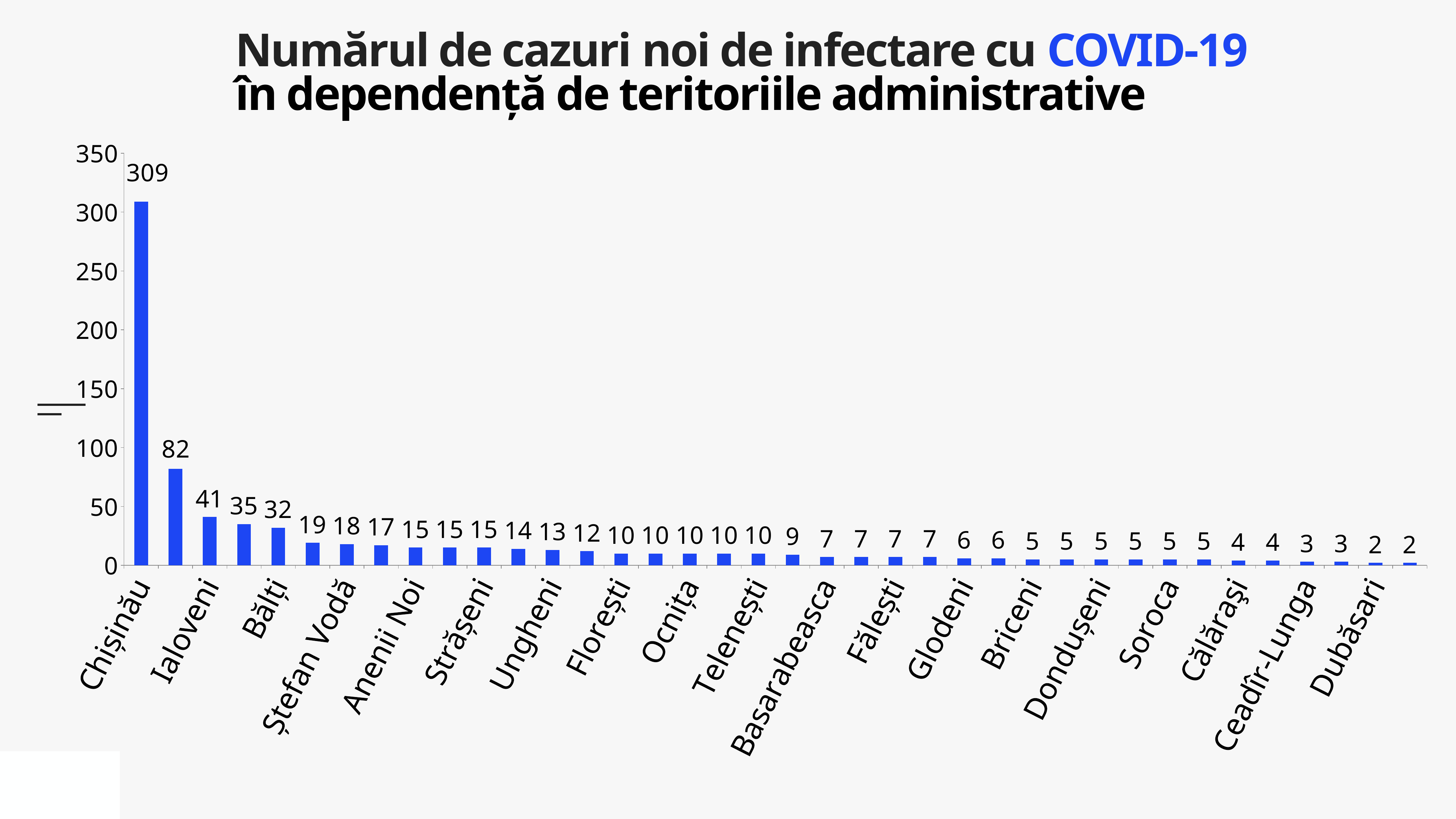
How many new COVID-19 cases are shown for Soroca? 5 Do the values rise or fall from left to right along the x axis? fall Which administrative territory has the highest number of new COVID-19 cases? Chișinău What type of chart is shown on the slide? bar chart How many new COVID-19 cases are shown for Dubăsari? 2 How many new COVID-19 cases are shown for Chișinău? 309 Is the value for Chișinău greater or less than 300? greater How many new COVID-19 cases are shown for Ocnița? 10 Which has more new cases, Chișinău or Ialoveni? Chișinău How many new COVID-19 cases are shown for Glodeni? 6 What is the difference between the highest bar and the second-highest bar? 227 What is the highest value shown on the vertical axis? 350